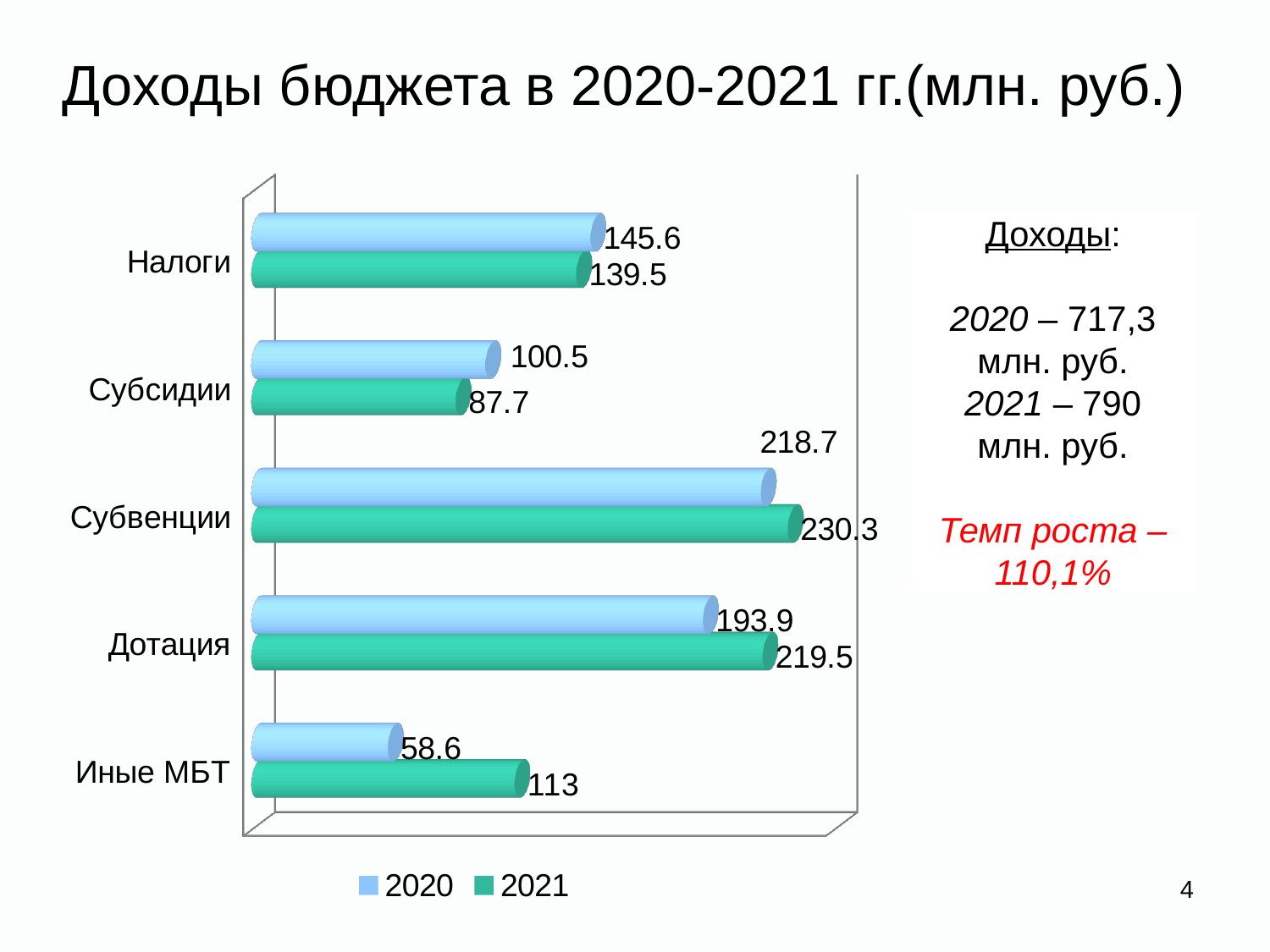
What is the difference between the 2021 and 2020 values for Дотация? 25.6 What is the title of the slide? Доходы бюджета в 2020-2021 гг.(млн. руб.) What kind of chart is shown on the slide? Bar chart What is the value for Субсидии in 2021? 87.7 Which category has the highest value in 2021? Субвенции Which category has the lowest value in 2020? Иные МБТ Which colour represents the 2021 series in the legend? Green How many categories are shown on the chart? 5 How many series does the legend list? 2 Which is larger for Субсидии: the 2020 value or the 2021 value? 2020 What is the value for Иные МБТ in 2021? 113 What is the value for Налоги in 2020? 145.6